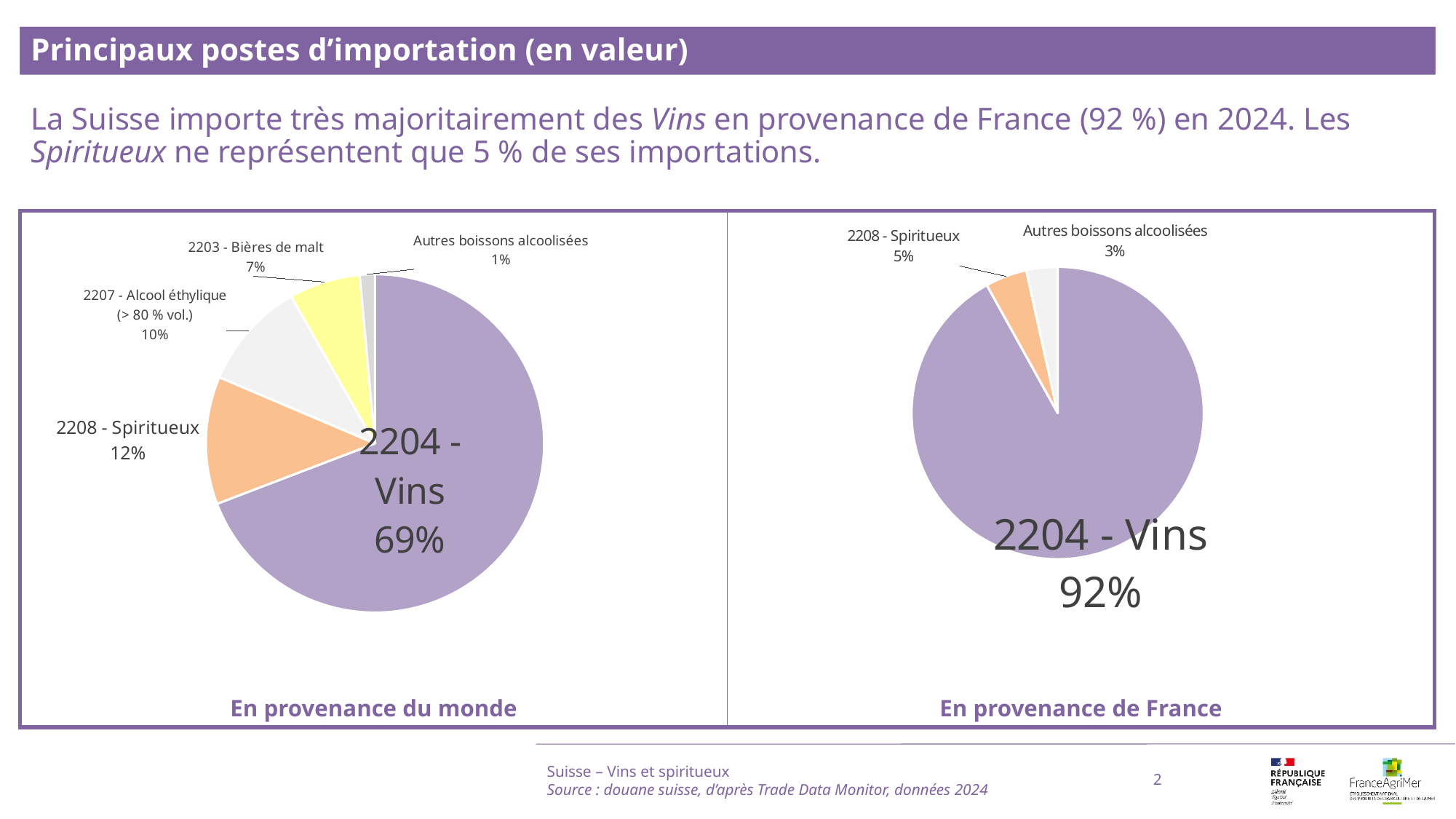
In the 'En provenance de France' pie chart, which is larger: '2208 - Spiritueux' or 'Autres boissons alcoolisées'? 2208 - Spiritueux In the 'En provenance du monde' pie chart, what is the difference in percentage points between '2208 - Spiritueux' and '2203 - Bières de malt'? 5 In the 'En provenance du monde' pie chart, what share does '2204 - Vins' have? 69% In the 'En provenance du monde' pie chart, what share does '2208 - Spiritueux' have? 12% In the 'En provenance de France' pie chart, what share does '2208 - Spiritueux' have? 5% In the 'En provenance de France' pie chart, how many slices are there? 3 In the 'En provenance du monde' pie chart, how many slices are there? 5 In the 'En provenance du monde' pie chart, which category has the smallest share? Autres boissons alcoolisées What type of chart is used on the slide? Pie chart